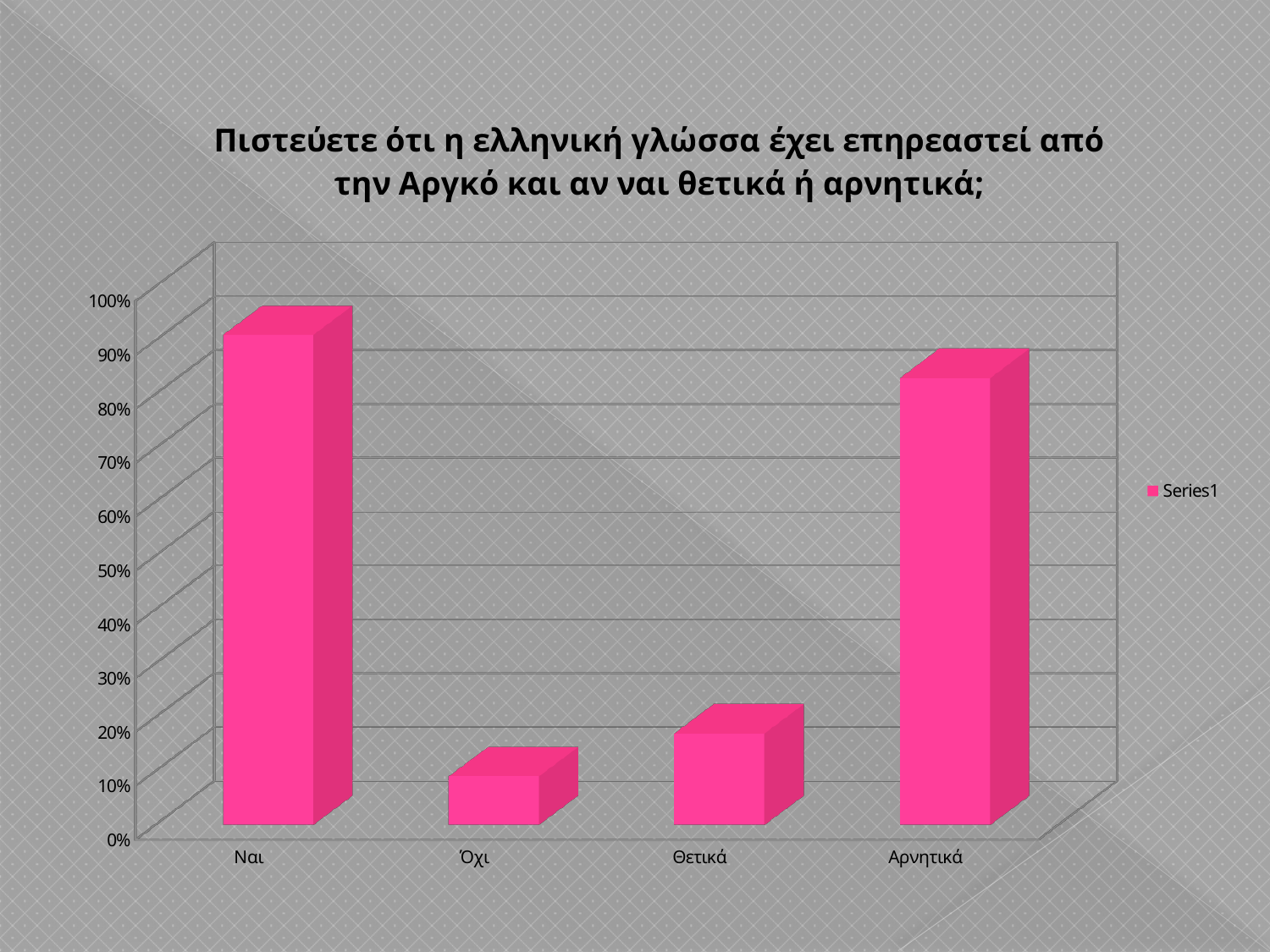
Which category has the lowest bar? Όχι Is the value for Ναι greater or less than 80%? greater Which is larger, the value for Ναι or the value for Αρνητικά? Ναι Is the value for Όχι greater or less than 20%? less Which category has the highest bar? Ναι How many categories are shown on the x axis of the chart? 4 Which is larger, the value for Θετικά or the value for Όχι? Θετικά Is the value for Θετικά greater or less than 30%? less What kind of chart is shown on the slide? bar chart What is the name of the series shown in the legend? Series1 How many series does the legend list? 1